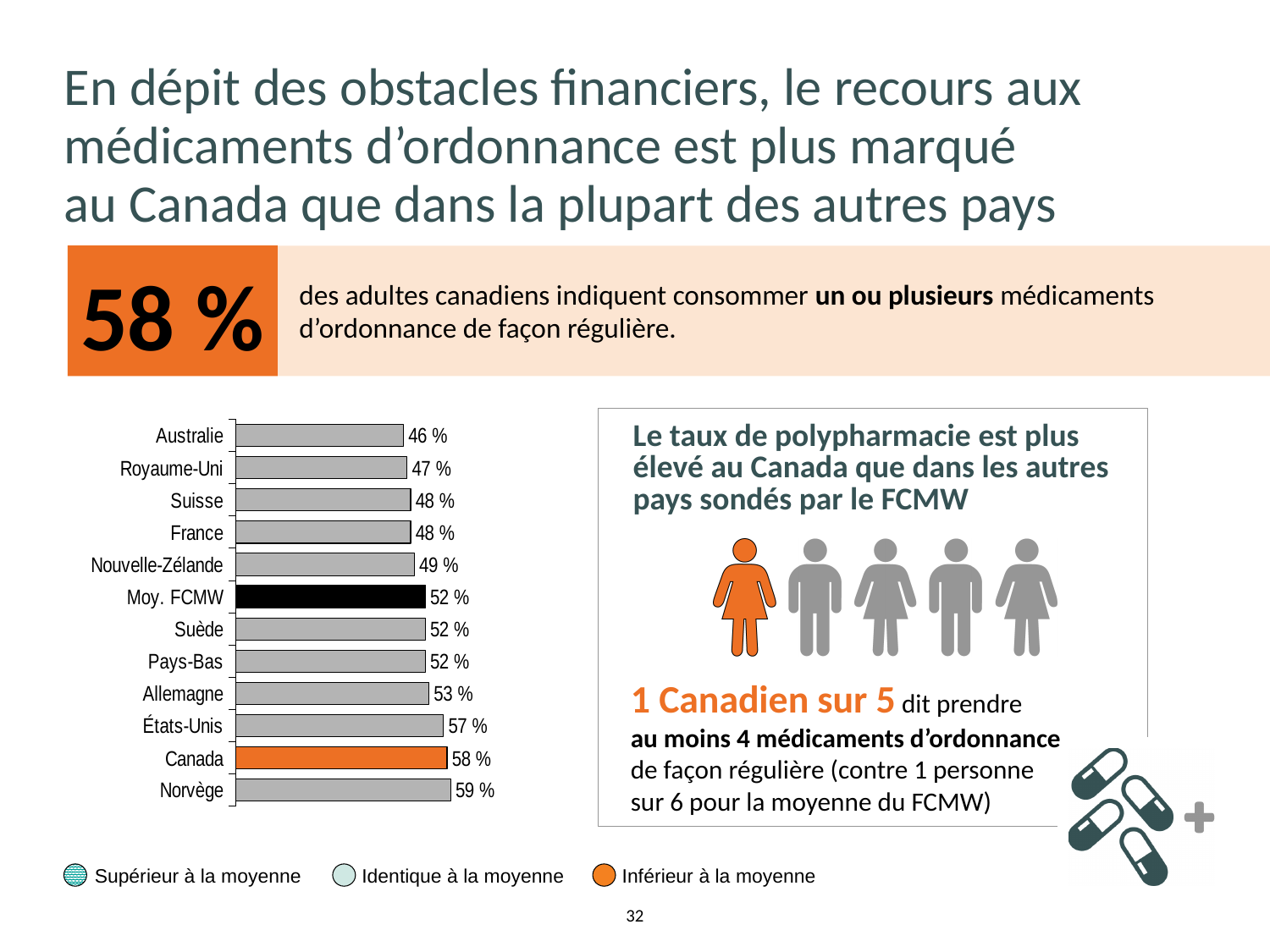
How many categories (bars) are shown in the bar chart? 12 What is the difference between the values for Norvège and Australie in the bar chart? 13 % What kind of chart is shown on the slide? Bar chart What is the value shown for Australie in the bar chart? 46 % What is the value shown for Canada in the bar chart? 58 % Which has a larger value in the bar chart, Nouvelle-Zélande or Royaume-Uni? Nouvelle-Zélande Which country has the highest value in the bar chart? Norvège Which country has the lowest value in the bar chart? Australie Which bar in the chart is coloured orange? Canada What is the difference between the values for Canada and Moy. FCMW in the bar chart? 6 % What is the value shown for Moy. FCMW in the bar chart? 52 % Which has a larger value in the bar chart, États-Unis or Allemagne? États-Unis